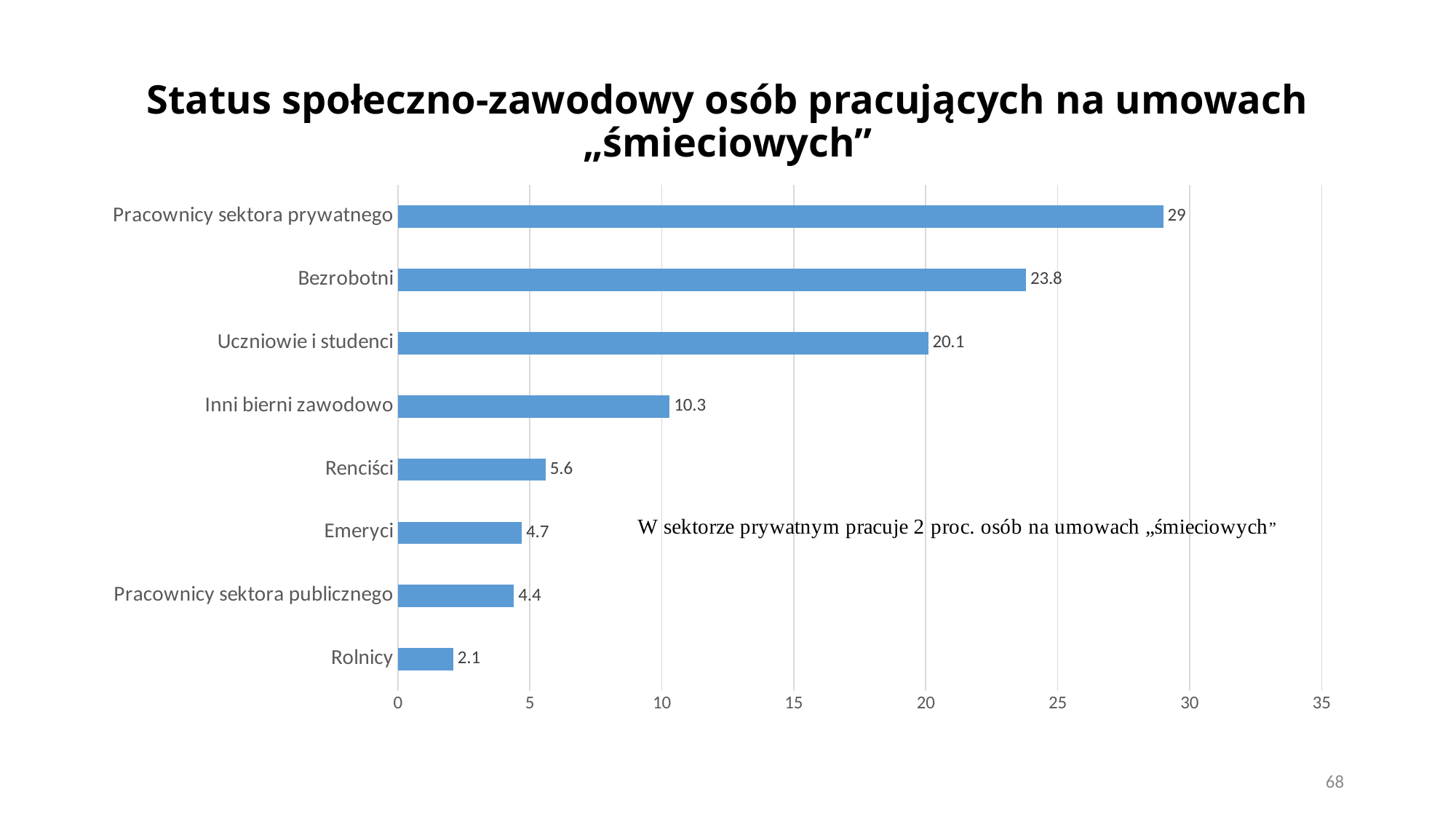
What is the difference between the values for Bezrobotni and Uczniowie i studenci? 3.7 What is the value for Pracownicy sektora prywatnego? 29 Which category has the lowest value? Rolnicy How many categories are shown in the chart? 8 What is the value for Bezrobotni? 23.8 What kind of chart is shown on the slide? bar chart What is the value for Uczniowie i studenci? 20.1 What is the title of the chart on the slide? Status społeczno-zawodowy osób pracujących na umowach „śmieciowych” What is the value for Emeryci? 4.7 Is the value for Inni bierni zawodowo greater or less than 15? less Which is larger, the value for Renciści or the value for Emeryci? Renciści Which category has the highest value? Pracownicy sektora prywatnego